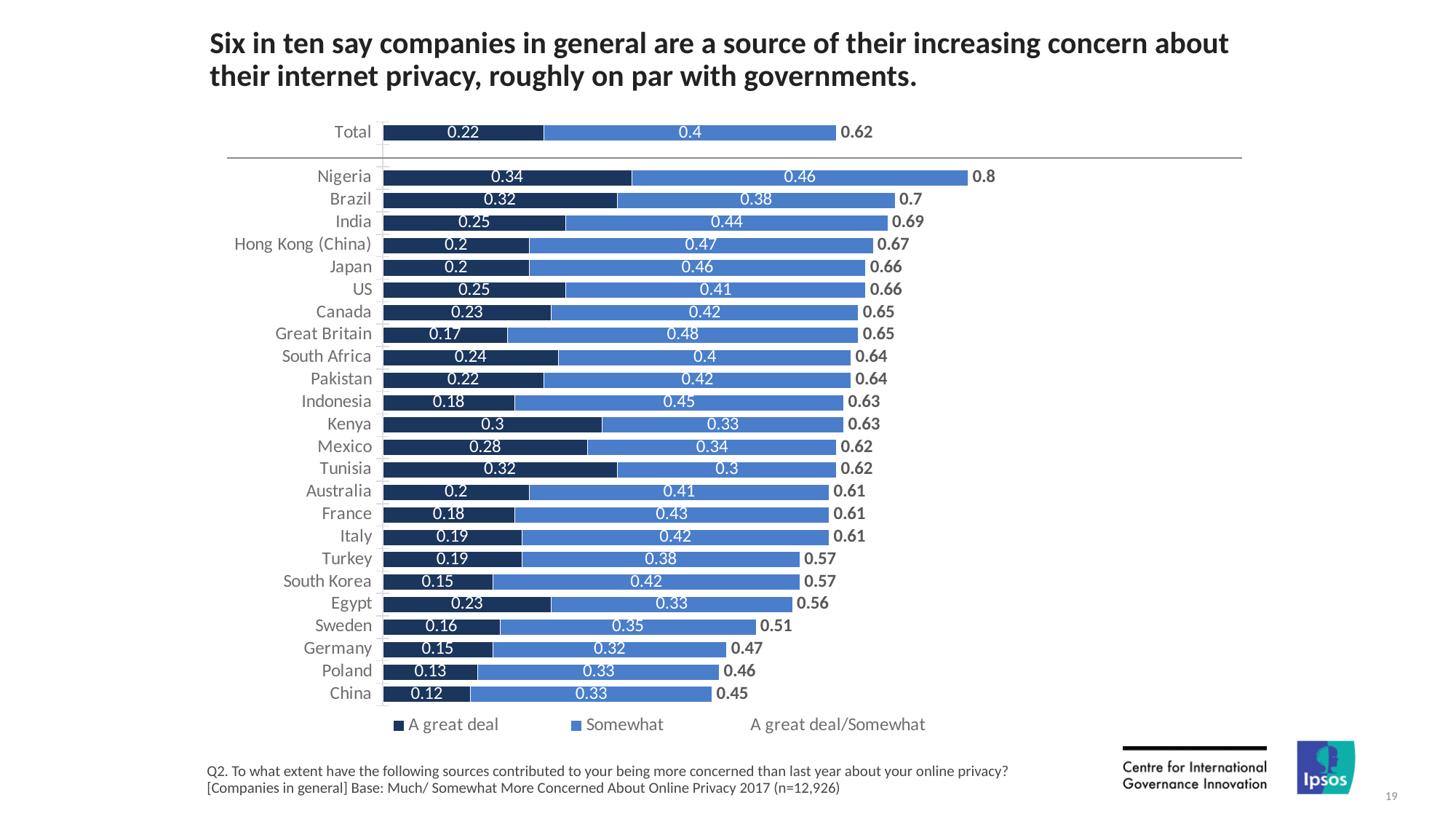
Which country has the highest combined 'A great deal/Somewhat' value? Nigeria What is the total of the stacked bar for Japan? 0.66 What is the difference between the 'A great deal' values for Brazil and Germany? 0.17 How many countries (excluding Total) are listed on the chart? 24 What is the 'Somewhat' value for Great Britain? 0.48 How many entries does the legend list? 3 Which has a larger 'Somewhat' value, Kenya or Indonesia? Indonesia What is the combined 'A great deal/Somewhat' value shown for Total? 0.62 What kind of chart is shown on the slide? Stacked bar chart Which legend entry is represented by the dark navy segments? A great deal Which country has the lowest combined 'A great deal/Somewhat' value? China What is the 'A great deal' value for Nigeria? 0.34